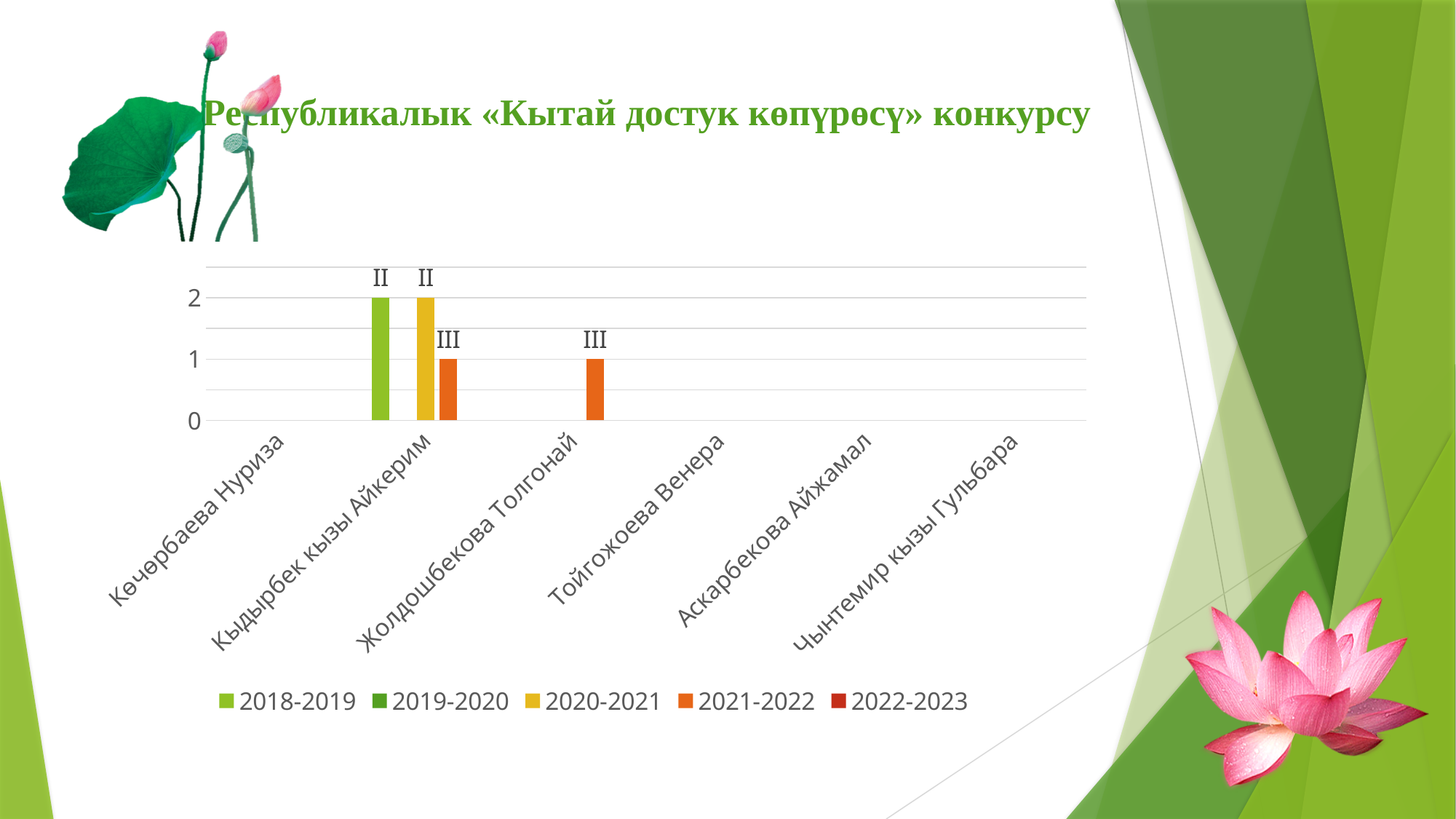
What value does the 2020-2021 bar for Кыдырбек кызы Айкерим reach on the axis? 2 What value does the 2018-2019 bar for Кыдырбек кызы Айкерим reach on the axis? 2 Which category has the most bars plotted? Кыдырбек кызы Айкерим How many categories (names) are shown on the x axis? 6 What label is printed above the 2018-2019 bar for Кыдырбек кызы Айкерим? II What label is printed above the 2021-2022 bar for Жолдошбекова Толгонай? III How many series does the legend list? 5 What kind of chart is shown on the slide? bar chart What value does the 2021-2022 bar for Жолдошбекова Толгонай reach on the axis? 1 What is the difference between the 2018-2019 bar and the 2021-2022 bar for Кыдырбек кызы Айкерим? 1 What value does the 2021-2022 bar for Кыдырбек кызы Айкерим reach on the axis? 1 Which is larger: the 2020-2021 bar or the 2021-2022 bar for Кыдырбек кызы Айкерим? 2020-2021